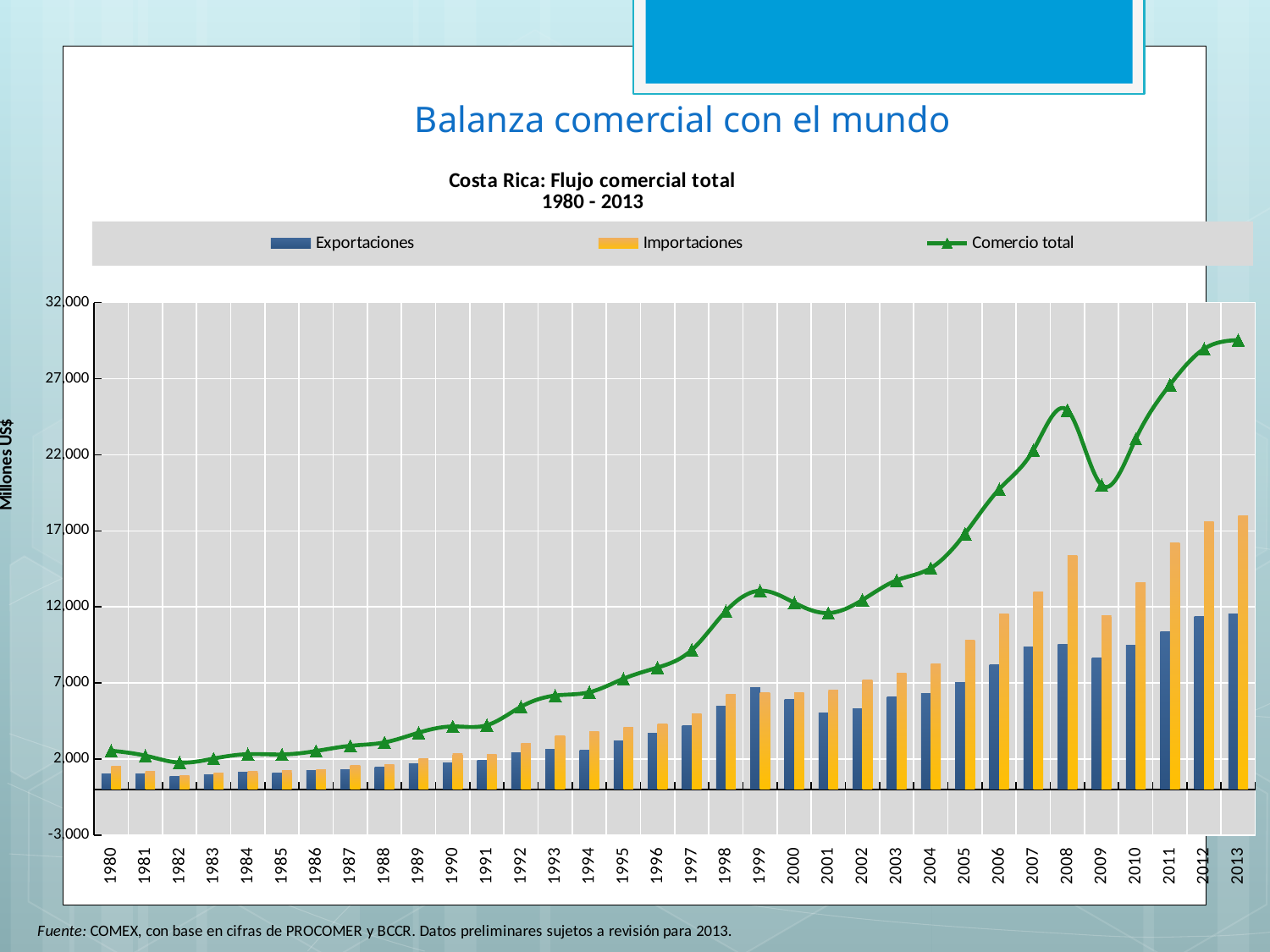
How many series does the legend list? 3 What is the unit shown on the y axis label? Millones US$ Is the value of Importaciones in 2013 greater or less than 17,000? greater Is the value of Comercio total in 2013 greater or less than 27,000? greater In 2013, which is larger, Exportaciones or Importaciones? Importaciones Which series is plotted as a green line with triangle markers? Comercio total Does Comercio total generally rise or fall from 1980 to 2013? Rise What kind of chart is shown on the slide? A combined bar and line chart Is the value of Comercio total in 2009 greater or less than 22,000? less In which year is Comercio total highest? 2013 How many years are shown on the x axis? 34 In which year is Comercio total lowest? 1982